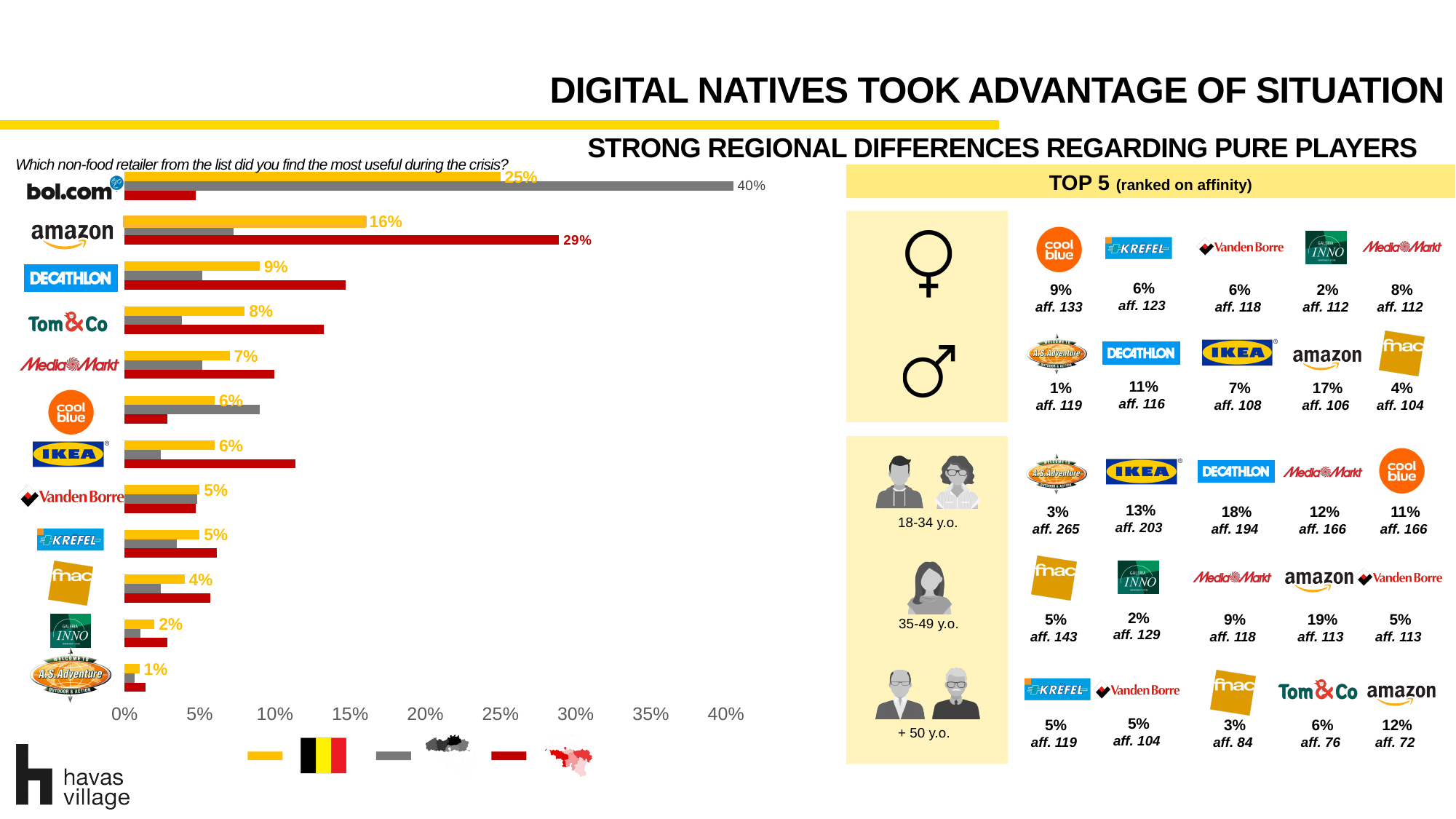
In the bar chart on the left, what is the difference between the yellow-bar values for bol.com and amazon? 9 percentage points In the bar chart on the left, which has the larger yellow-bar value, amazon or fnac? amazon What type of chart is shown on the left of the slide? Bar chart In the bar chart on the left, what is the value of the grey (middle) bar for bol.com? 40% In the bar chart on the left, what is the value of the yellow bar for Decathlon? 9% In the bar chart on the left, which retailer has the lowest yellow-bar value? A.S. Adventure In the bar chart on the left, what is the value of the red (bottom) bar for amazon? 29% How many retailers are shown in the bar chart on the left? 12 How many series (bar colours) does the legend of the bar chart on the left show? 3 In the bar chart on the left, is the grey bar for Coolblue greater or less than 5%? greater In the bar chart on the left, which retailer has the highest yellow-bar value? bol.com In the bar chart on the left, what is the value of the yellow (top) bar for bol.com? 25%